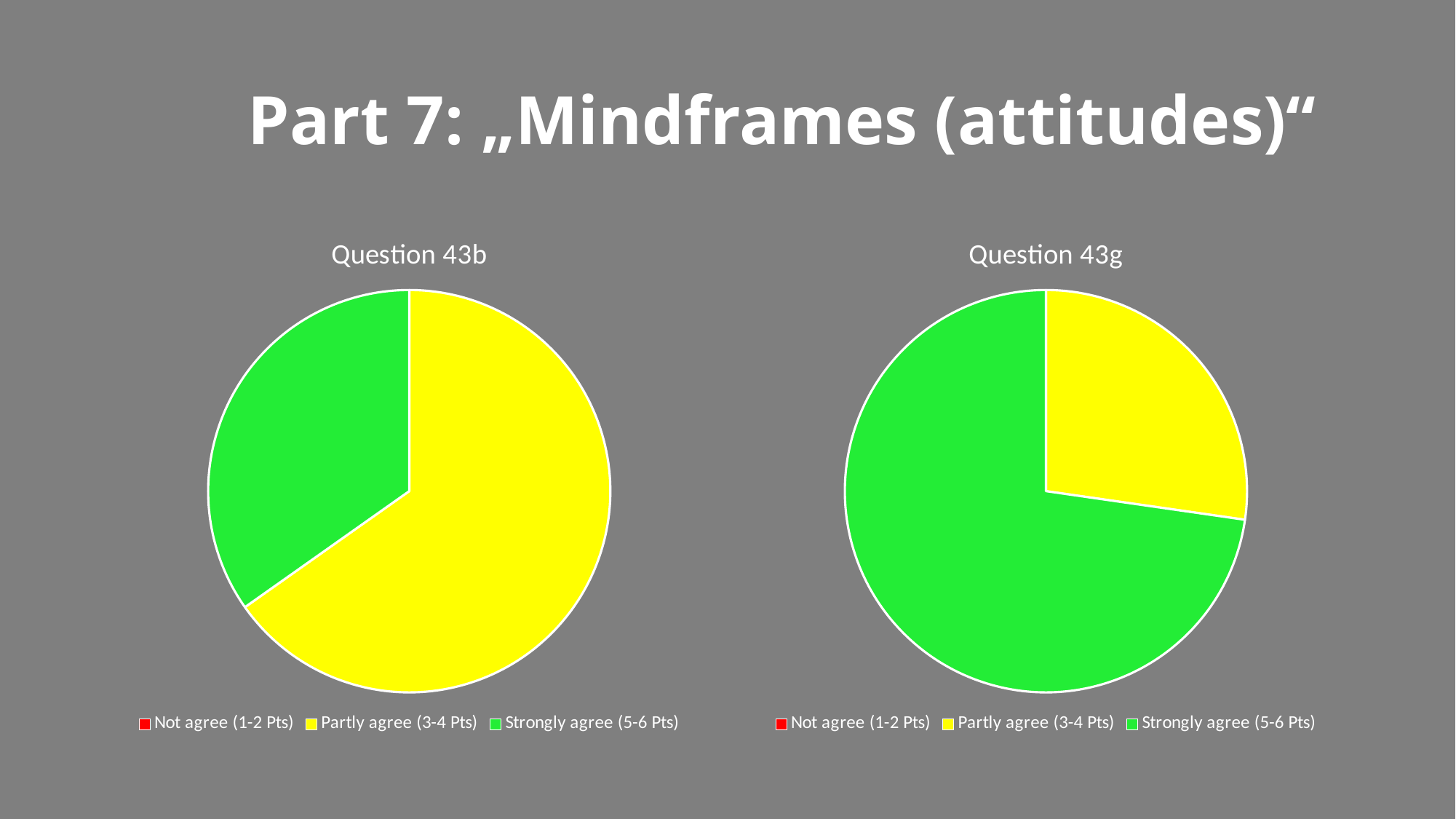
In the Question 43g chart, is the Strongly agree (5-6 Pts) slice larger or smaller than the Partly agree (3-4 Pts) slice? larger Is the Strongly agree (5-6 Pts) share in the Question 43g chart greater or less than 50%? greater How many categories does the legend of the Question 43b chart list? 3 Which legend category has no visible slice in the Question 43b chart? Not agree (1-2 Pts) What colour represents Strongly agree (5-6 Pts) in the Question 43g chart? green In the Question 43b chart, which category has the largest slice? Partly agree (3-4 Pts) In the Question 43b chart, which of the visible slices is smaller, Partly agree (3-4 Pts) or Strongly agree (5-6 Pts)? Strongly agree (5-6 Pts) What kind of chart is used for Question 43b? pie chart In the Question 43b chart, is the Partly agree (3-4 Pts) slice larger or smaller than the Strongly agree (5-6 Pts) slice? larger How many slices are visible in the Question 43g pie chart? 2 In the Question 43g chart, which category has the largest slice? Strongly agree (5-6 Pts) In the Question 43g chart, which of the visible slices is smaller, Partly agree (3-4 Pts) or Strongly agree (5-6 Pts)? Partly agree (3-4 Pts)